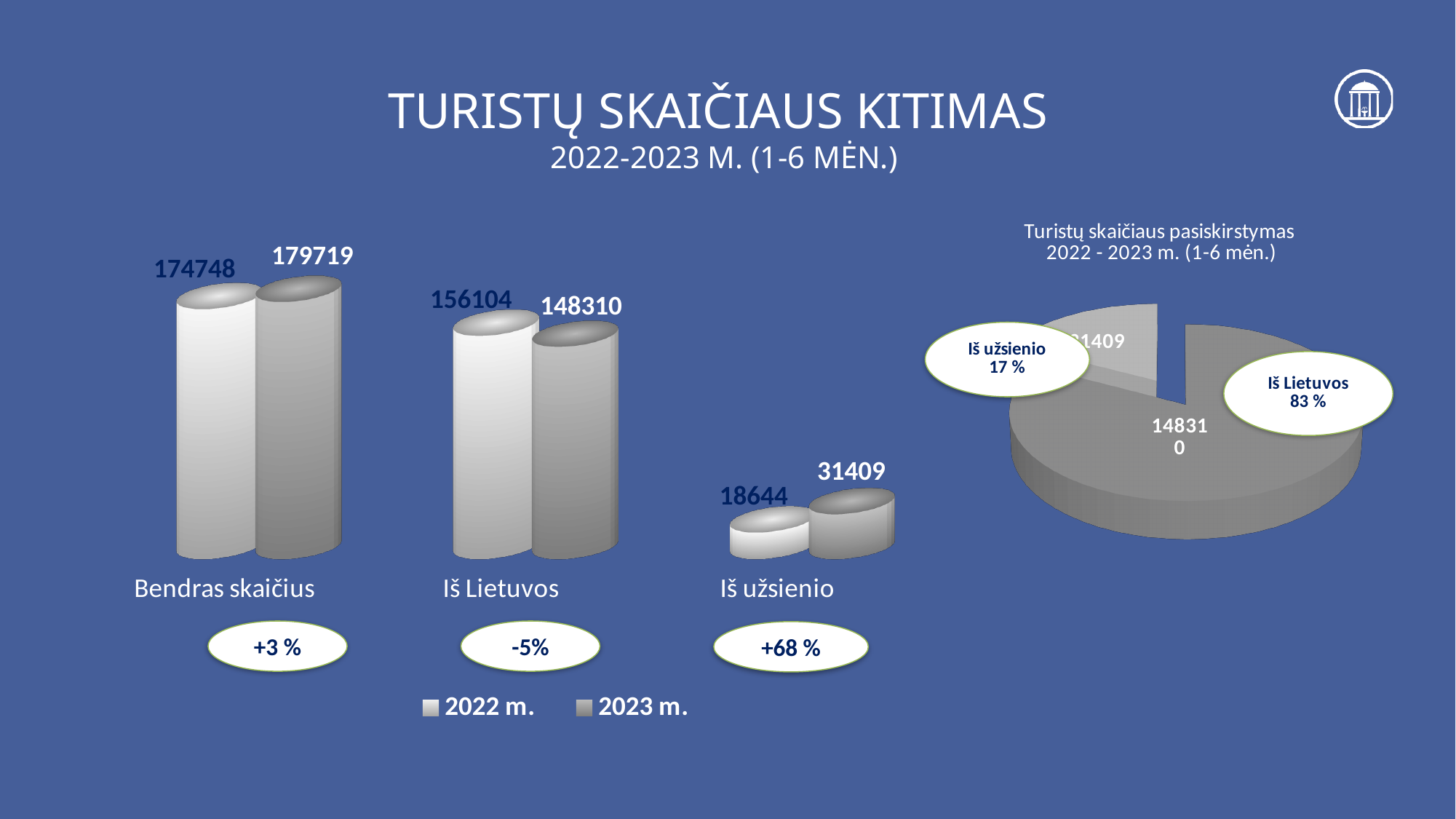
In the pie chart titled 'Turistų skaičiaus pasiskirstymas 2022 - 2023 m. (1-6 mėn.)', what share does Iš Lietuvos have? 83 % In the bar chart on the left, what is the difference between the 2023 m. and 2022 m. values for Iš užsienio? 12765 In the bar chart on the left, what is the value for Iš Lietuvos in 2022 m.? 156104 What kind of chart is the chart on the right of the slide? Pie chart In the bar chart on the left, which category has the highest value for 2023 m.? Bendras skaičius In the bar chart on the left, how many categories are shown on the x axis? 3 What kind of chart is the chart on the left of the slide? Bar chart In the bar chart on the left, how many series does the legend list? 2 In the bar chart on the left, which category has the lowest value for 2022 m.? Iš užsienio In the bar chart on the left, which is larger for Iš Lietuvos: the 2022 m. value or the 2023 m. value? 2022 m. In the bar chart on the left, what is the value for Iš užsienio in 2023 m.? 31409 In the bar chart on the left, what is the value for Bendras skaičius in 2023 m.? 179719